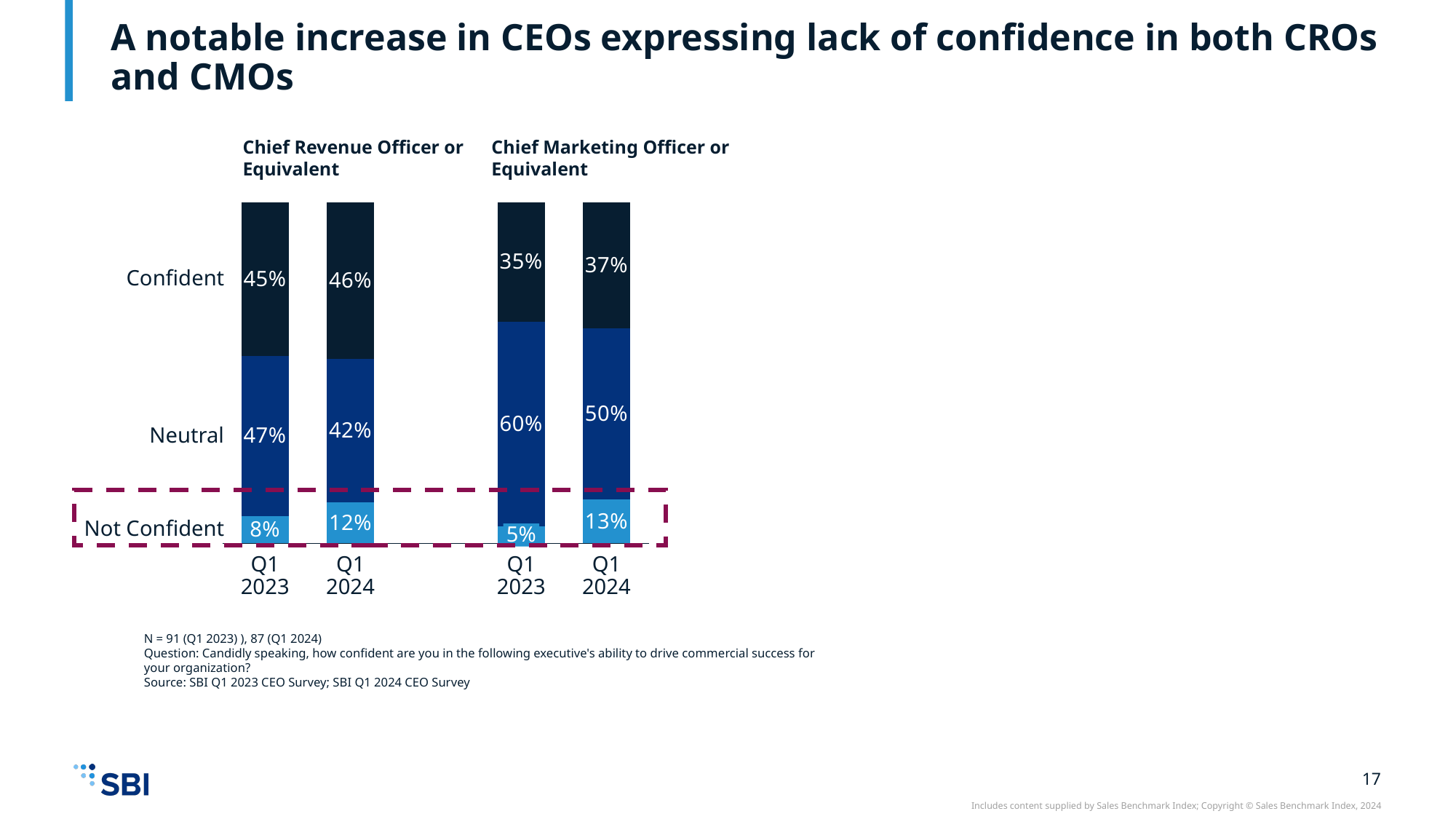
What percentage of CEOs were Confident in the Chief Marketing Officer or Equivalent in Q1 2023? 35% How many categories (Confident, Neutral, Not Confident) are stacked in each bar? 3 Which is larger: the Confident percentage for the Chief Revenue Officer or Equivalent in Q1 2024 or for the Chief Marketing Officer or Equivalent in Q1 2024? Chief Revenue Officer or Equivalent in Q1 2024 What is the Neutral percentage for the Chief Revenue Officer or Equivalent in Q1 2023? 47% By how many percentage points did the Not Confident share for the Chief Marketing Officer or Equivalent change from Q1 2023 to Q1 2024? 8 percentage points How many bars are shown in the chart? 4 Which bar has the lowest Not Confident percentage? Chief Marketing Officer or Equivalent, Q1 2023 What type of chart is shown on the slide? Stacked bar chart Which bar has the highest Neutral percentage? Chief Marketing Officer or Equivalent, Q1 2023 What is the Neutral percentage for the Chief Marketing Officer or Equivalent in Q1 2024? 50% Which category is highlighted by the dashed box at the bottom of the chart? Not Confident What percentage of CEOs were Not Confident in the Chief Revenue Officer or Equivalent in Q1 2024? 12%